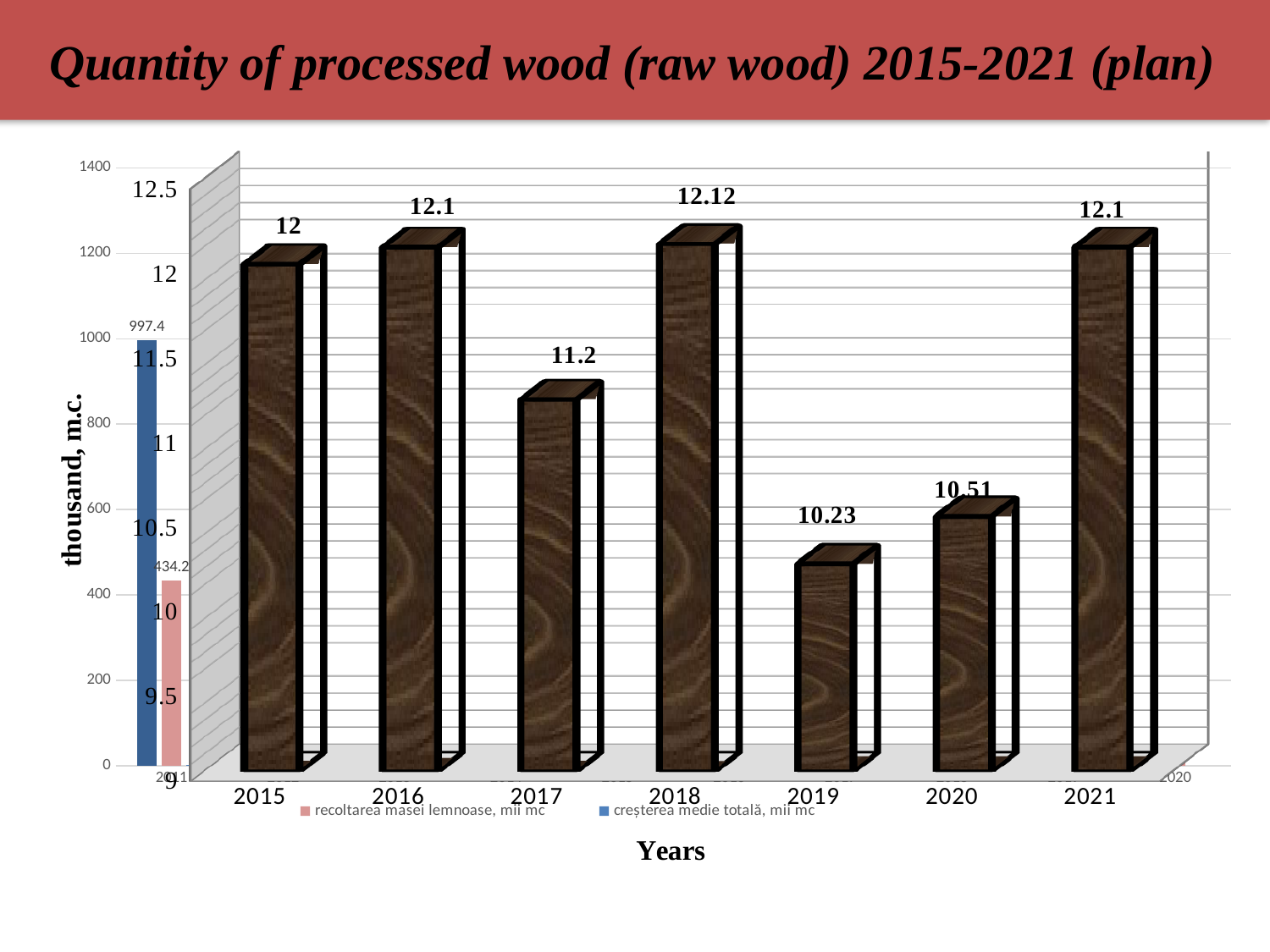
On the main bar chart, what is the value for 2017? 11.2 On the main bar chart, what is the value for 2020? 10.51 On the main bar chart, what is the value for 2018? 12.12 What kind of chart is the main chart on the slide? bar chart On the main bar chart, which is larger, the value for 2017 or the value for 2020? 2017 How many years are shown on the main bar chart? 7 On the small background chart at the left, what is the value of the blue bar labelled 'creșterea medie totală, mii mc'? 997.4 On the main bar chart, which year has the lowest value? 2019 On the main bar chart, what is the value for 2019? 10.23 On the main bar chart, which year has the highest value? 2018 What is the title of the slide's chart? Quantity of processed wood (raw wood) 2015-2021 (plan) On the main bar chart, what is the difference between the values for 2018 and 2019? 1.89